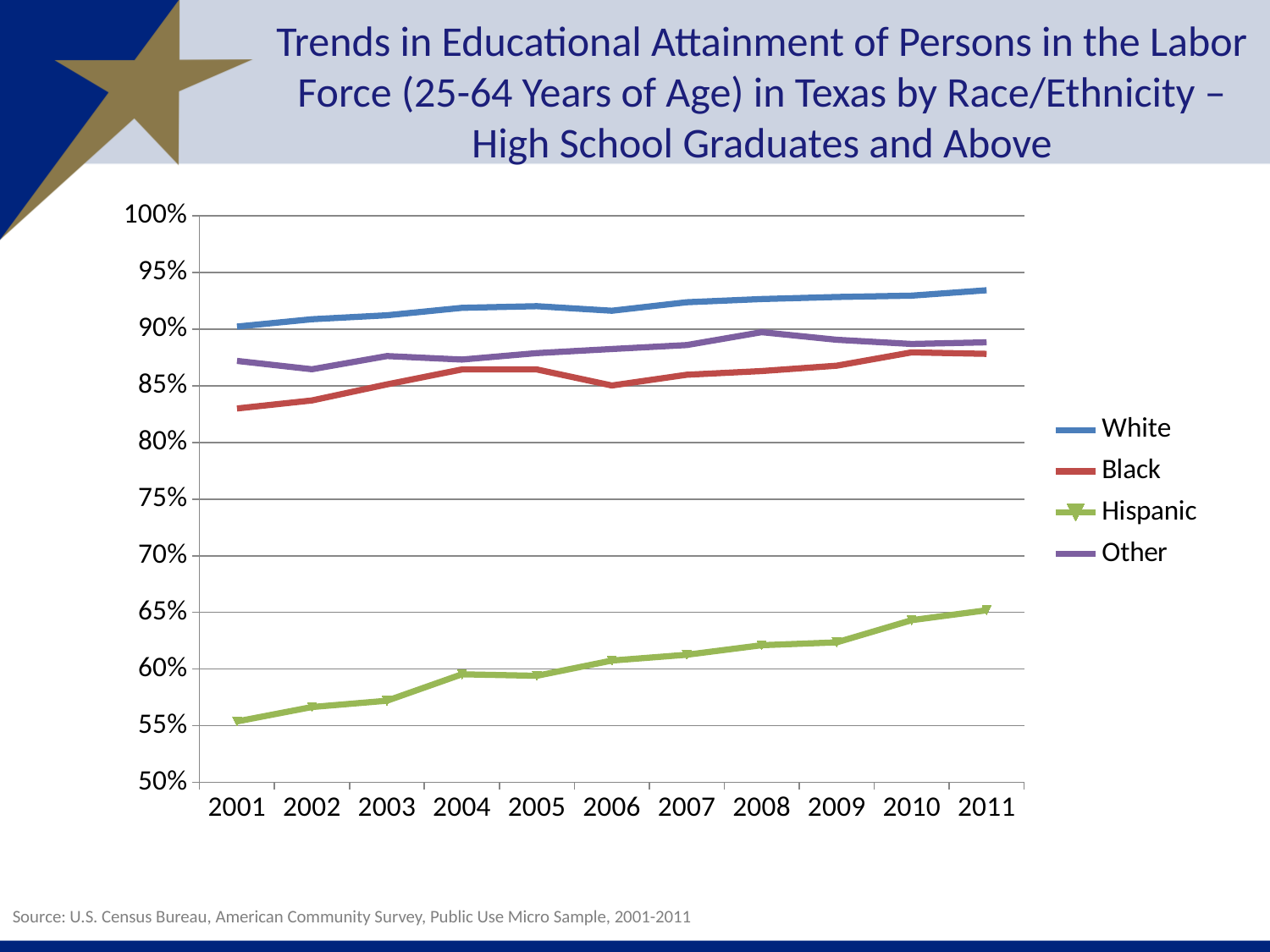
Does the Hispanic line rise or fall from 2001 to 2011? rises Is the value for Black in 2001 greater or less than 85%? less Is the value for Hispanic in 2001 greater or less than 60%? less Which series has the lowest value in 2011? Hispanic Which series has the highest value in 2011? White What kind of chart is shown on the slide? line chart How many years are shown along the x axis? 11 Is the value for Hispanic in 2011 greater or less than 60%? greater How many series does the legend list? 4 In 2008, which is higher: the value for Other or the value for Black? Other What are the four entries listed in the legend? White, Black, Hispanic, Other